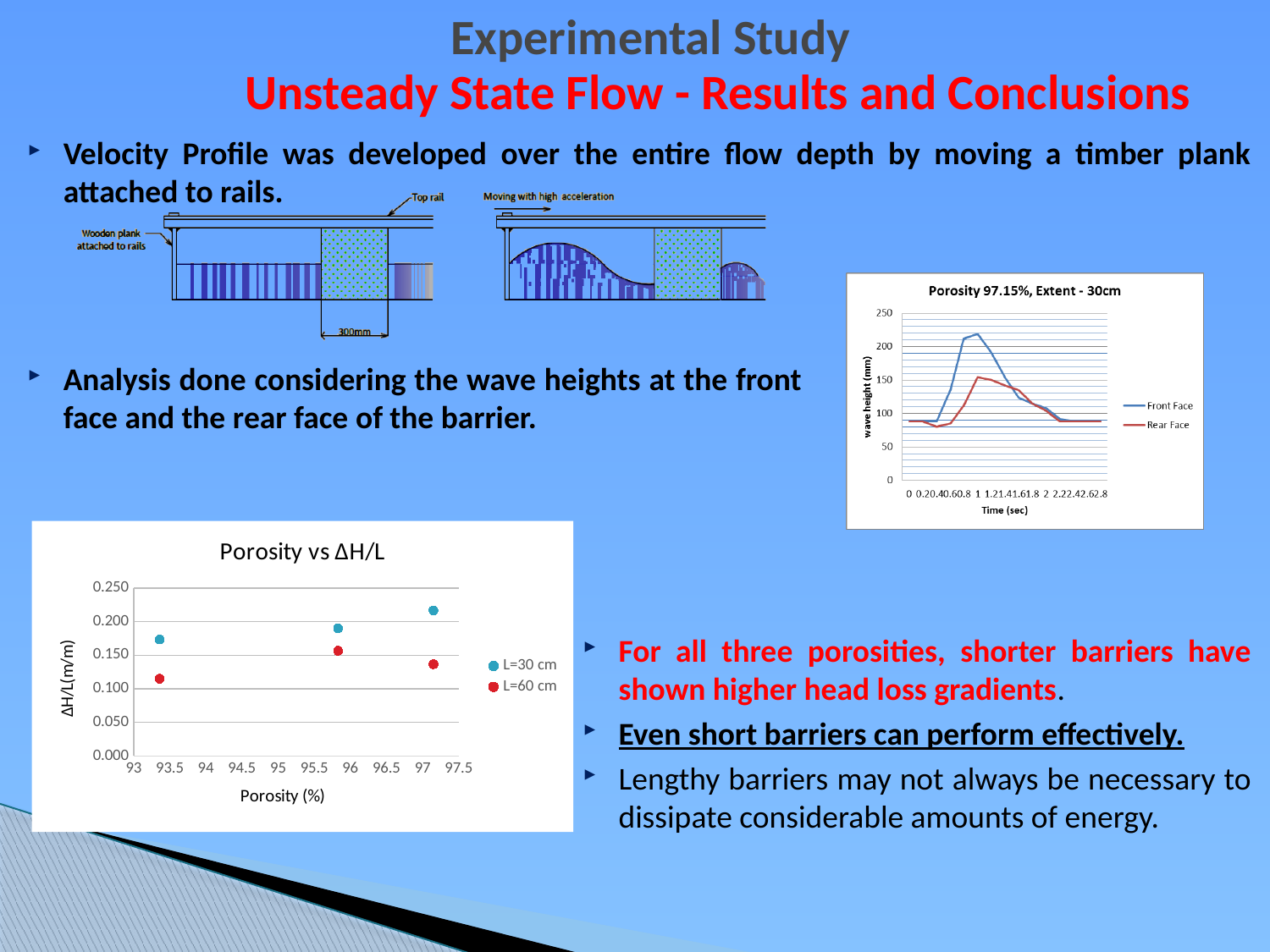
How many series does the legend of the "Porosity vs ΔH/L" chart list? 2 In the "Porosity vs ΔH/L" chart, is the ΔH/L value for L=30 cm at a porosity of about 97% greater or less than 0.200? greater In the "Porosity vs ΔH/L" chart, how many data points are plotted for the L=30 cm series? 3 How many series does the legend of the "Porosity 97.15%, Extent - 30cm" chart list? 2 What is the x-axis label of the "Porosity vs ΔH/L" chart? Porosity (%) What are the two series named in the legend of the "Porosity vs ΔH/L" chart? L=30 cm and L=60 cm What kind of chart is the "Porosity vs ΔH/L" chart? scatter chart In the "Porosity vs ΔH/L" chart, is the ΔH/L value for L=60 cm at a porosity of about 93.5% greater or less than 0.150? less What kind of chart is the "Porosity 97.15%, Extent - 30cm" chart? line chart In the "Porosity 97.15%, Extent - 30cm" chart, which series reaches the higher peak wave height, Front Face or Rear Face? Front Face In the "Porosity vs ΔH/L" chart, do the L=30 cm values rise or fall as porosity increases? rise In the "Porosity vs ΔH/L" chart, at a porosity of about 97%, which series has the larger ΔH/L value, L=30 cm or L=60 cm? L=30 cm